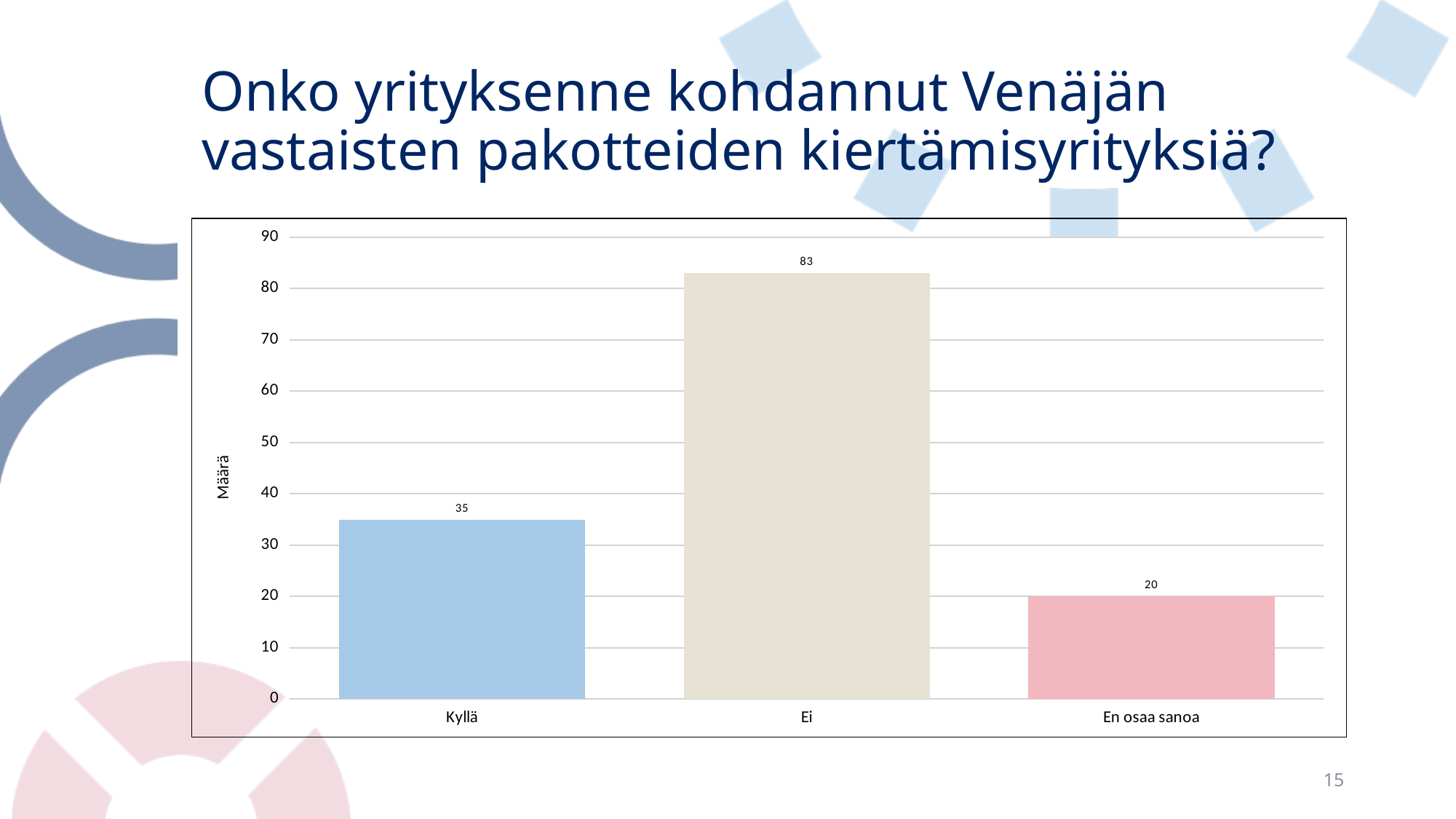
Which category has the lowest value? En osaa sanoa Which is larger, the value for Kyllä or the value for En osaa sanoa? Kyllä What is the difference between the values for Kyllä and En osaa sanoa? 15 What is the value for En osaa sanoa? 20 What is the value for Kyllä? 35 Which category has the highest value? Ei Is the value for Ei greater or less than 80? greater What kind of chart is shown on the slide? bar chart How many categories are shown on the x axis? 3 What is the difference between the values for Ei and Kyllä? 48 What is the label of the vertical axis? Määrä What is the value for Ei? 83